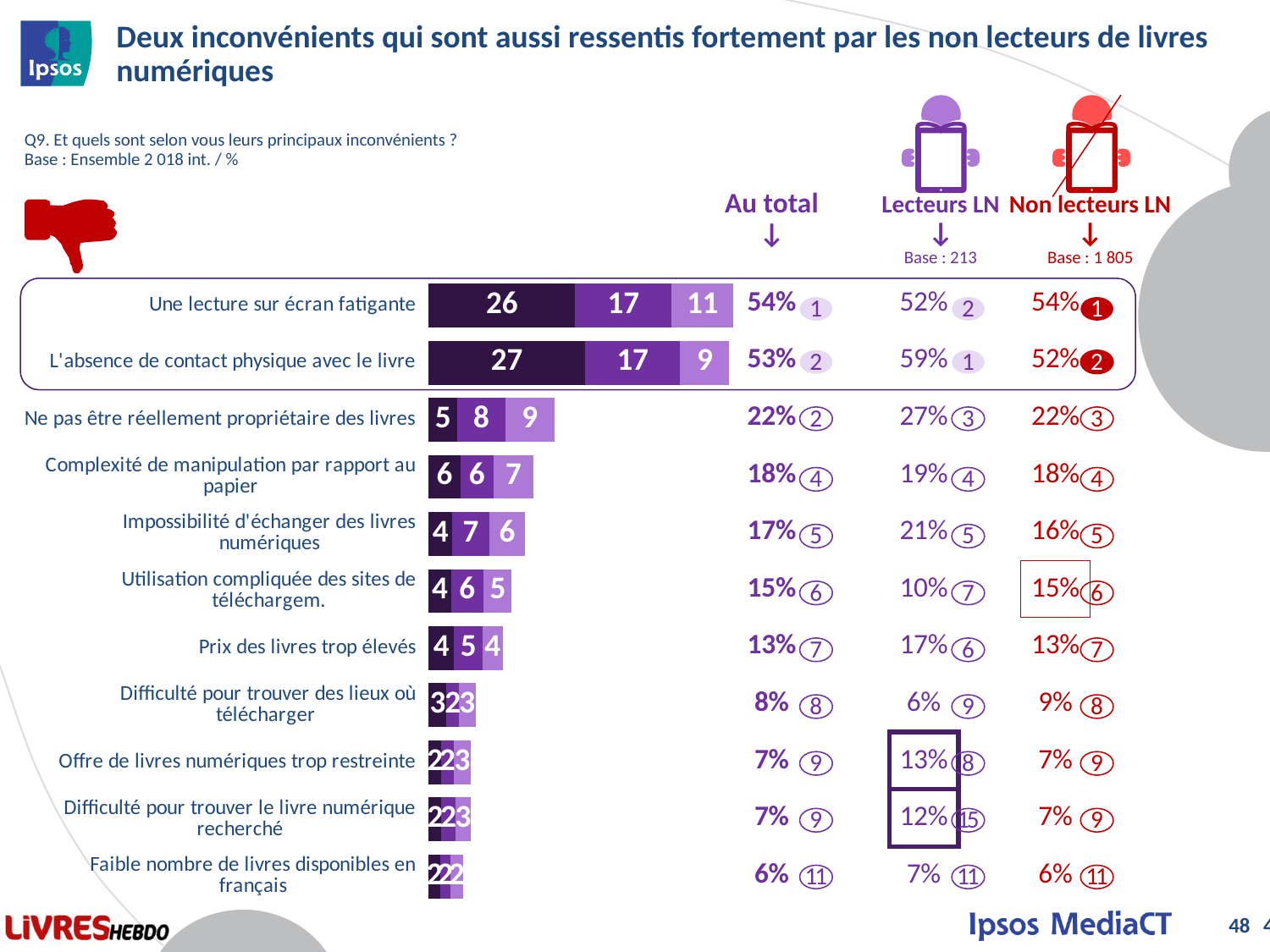
For "Utilisation compliquée des sites de téléchargem.", which group has the larger value: Lecteurs LN or Non lecteurs LN? Non lecteurs LN Which inconvenient has the highest "Au total" value? Une lecture sur écran fatigante What is the base (number of respondents) for the Non lecteurs LN column? 1 805 What kind of chart is used to show the inconvenients on this slide? Bar chart For "L'absence de contact physique avec le livre", what is the difference between the Lecteurs LN value and the Non lecteurs LN value? 7 points Which inconvenient has the lowest "Au total" value? Faible nombre de livres disponibles en français What is the Lecteurs LN value for "Offre de livres numériques trop restreinte"? 13% What is the base for the Lecteurs LN column? 213 What is the "Au total" value for "Ne pas être réellement propriétaire des livres"? 22% What is the total of the three stacked segments for "L'absence de contact physique avec le livre"? 53 How many inconvenients (categories) are listed in the chart? 11 What is the value of the first (darkest) segment of the bar for "Une lecture sur écran fatigante"? 26